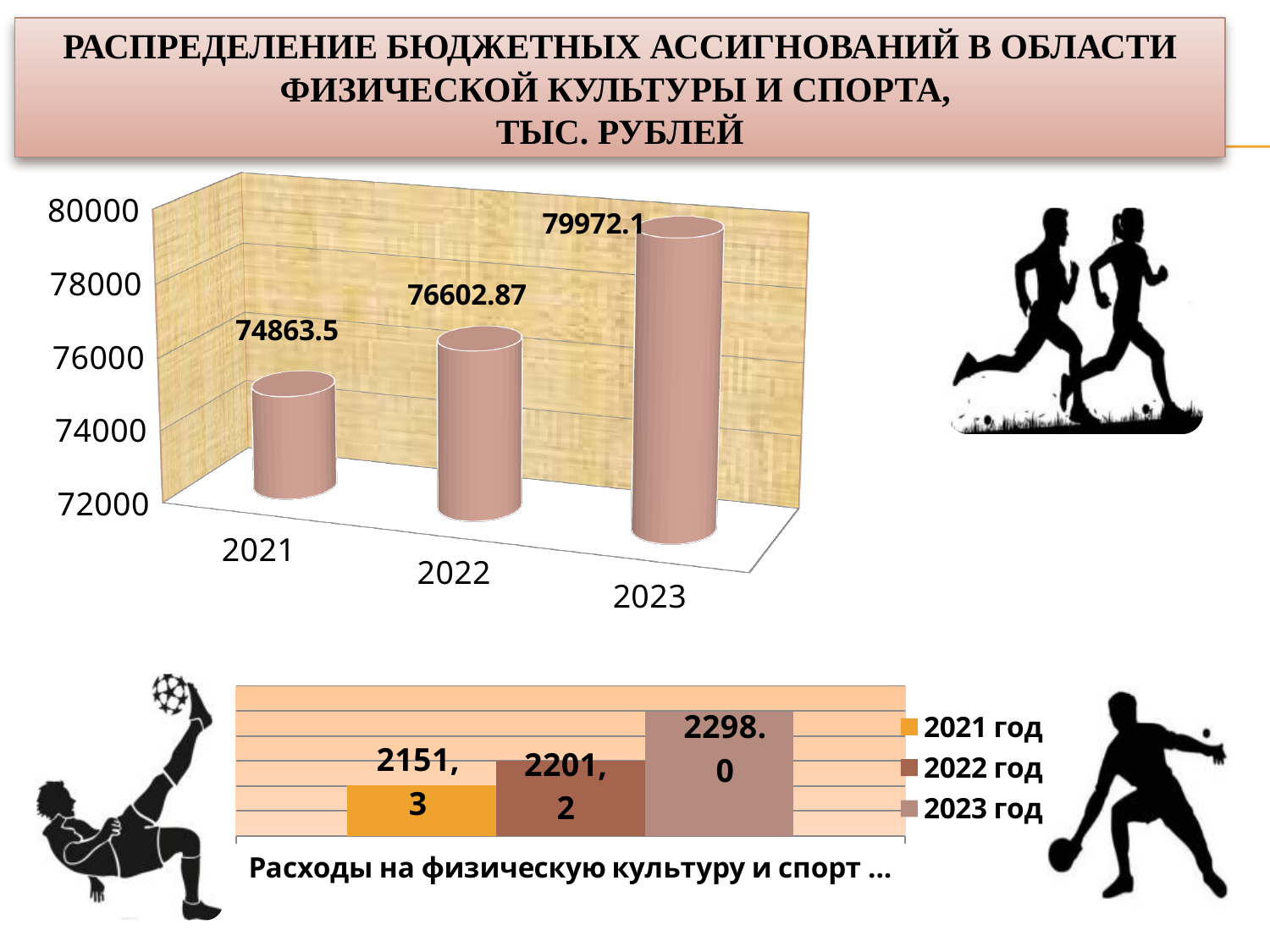
In the top chart, how many years are plotted? 3 In the top chart, do the values rise or fall from 2021 to 2023? rise In the bottom chart, what is the value for 2023 год? 2298,0 In the bottom chart, which is larger, the value for 2021 год or the value for 2023 год? 2023 год In the top chart, which year has the highest value? 2023 In the bottom chart, how many series does the legend list? 3 In the bottom chart, what is the value for 2022 год? 2201,2 In the top chart, what is the value for 2023? 79972.1 In the top chart, which year has the lowest value? 2021 In the top chart, what is the difference between the values for 2023 and 2021? 5108.6 In the top chart, what is the value for 2021? 74863.5 In the top chart, what is the value for 2022? 76602.87